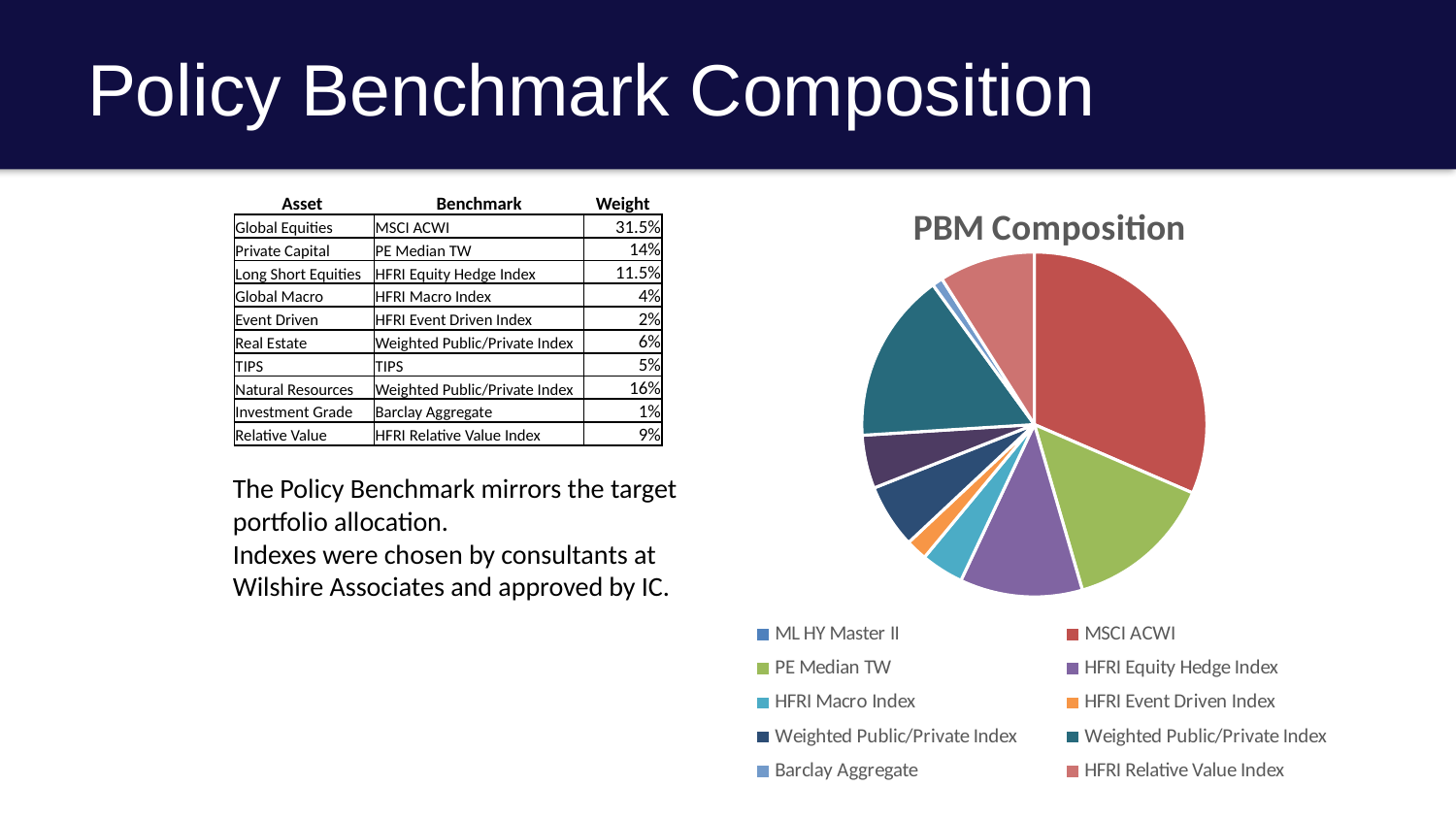
In the PBM Composition pie chart, which slice is larger: PE Median TW or HFRI Equity Hedge Index? PE Median TW Which legend entry appears twice in the PBM Composition chart's legend? Weighted Public/Private Index In the PBM Composition pie chart, which slice is larger: MSCI ACWI or PE Median TW? MSCI ACWI How many entries does the legend of the PBM Composition chart list? 10 What is the title of the chart on the slide? PBM Composition Which legend entry has the largest slice in the PBM Composition pie chart? MSCI ACWI What type of chart is shown on the slide? pie chart